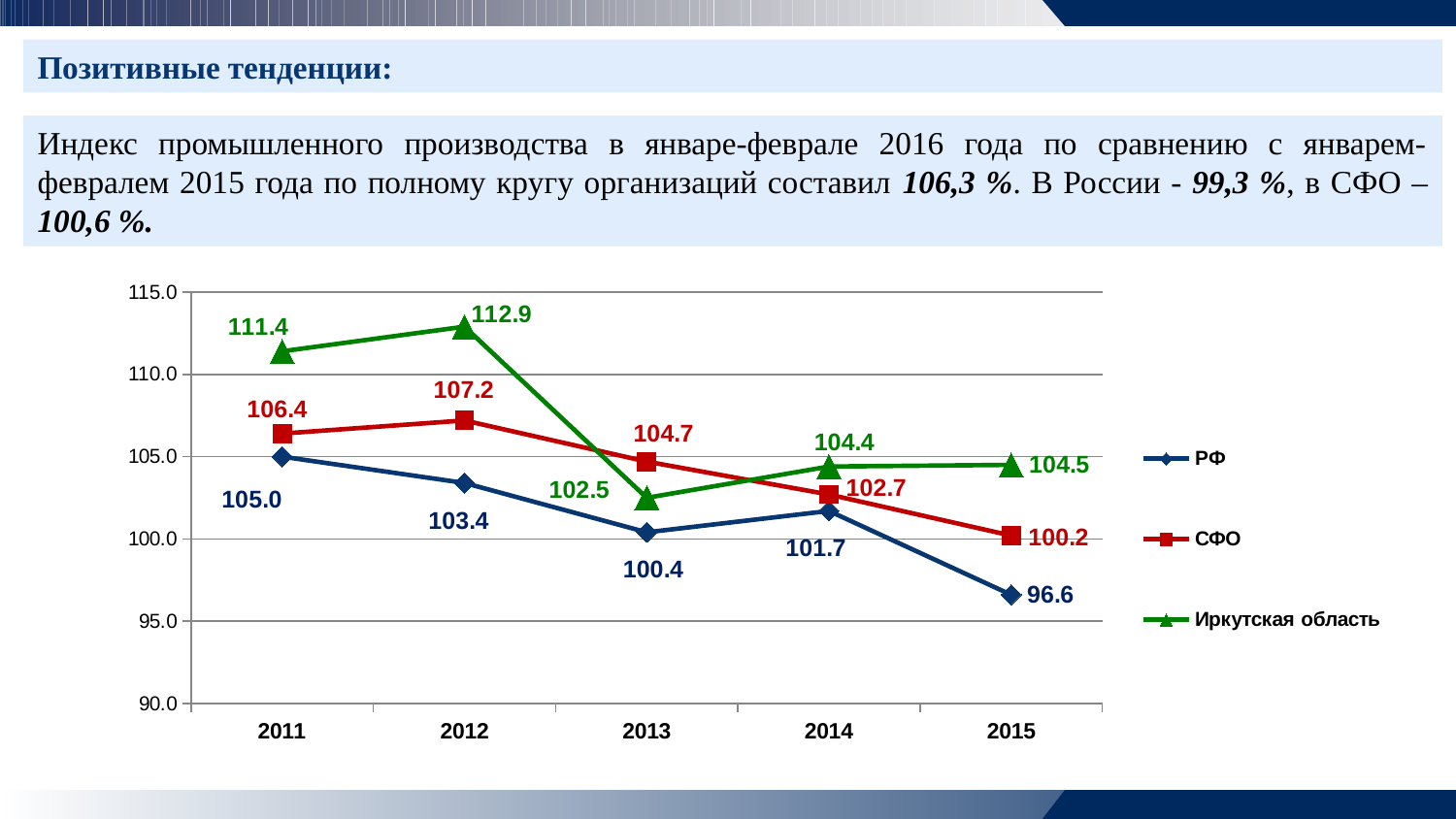
What is the value for РФ in 2015? 96.6 In which year is the value for Иркутская область the highest? 2012 Does the value for СФО rise or fall from 2012 to 2015? fall How many years are shown on the x axis? 5 What is the value for СФО in 2013? 104.7 What is the difference between the СФО values in 2011 and 2015? 6.2 In which year is the value for РФ the lowest? 2015 Which is larger in 2014: the value for СФО or the value for Иркутская область? Иркутская область Which series is drawn in green? Иркутская область What type of chart is shown on the slide? line chart What is the value for Иркутская область in 2012? 112.9 How many series does the legend list? 3